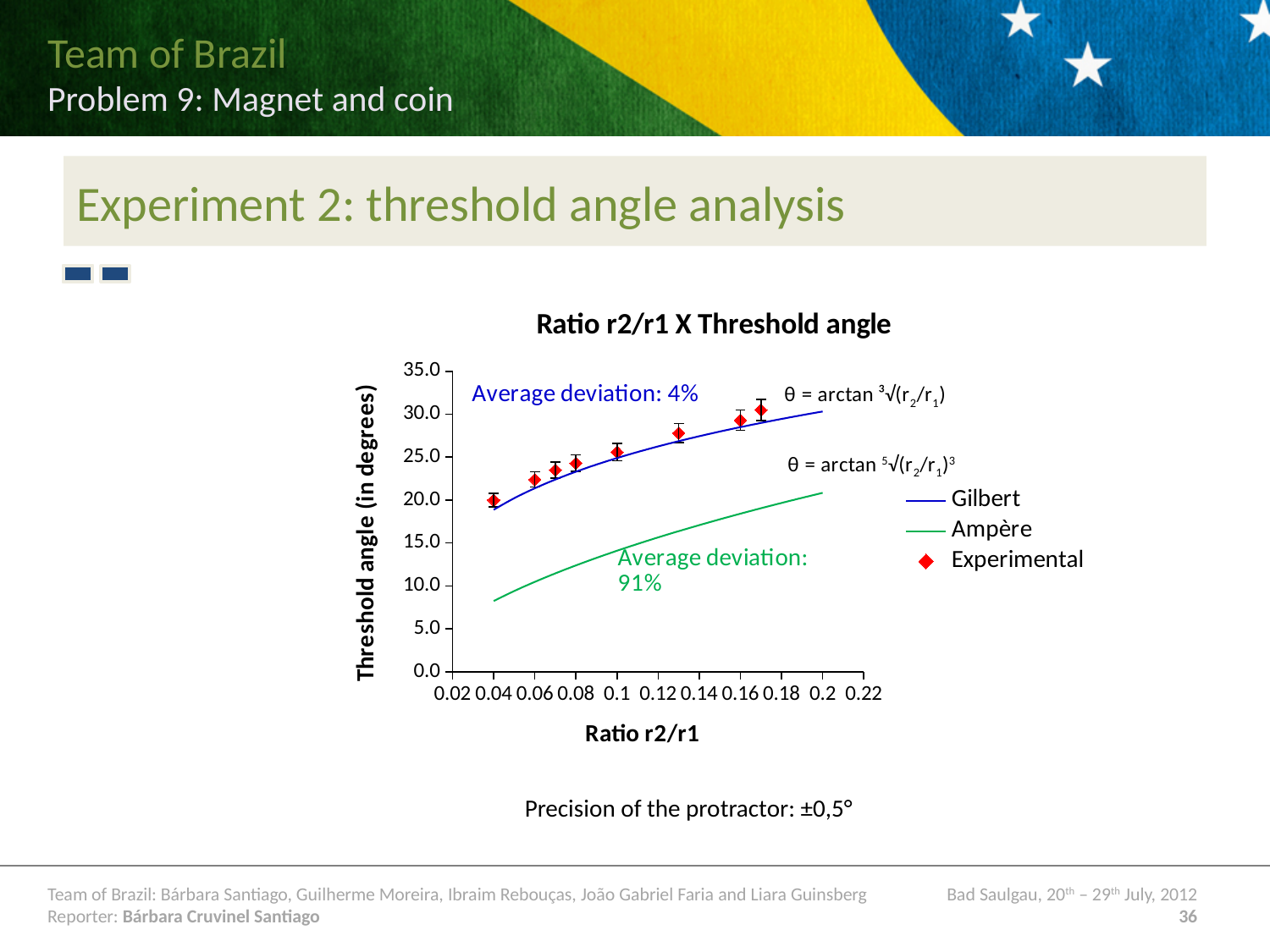
Is the experimental threshold angle at ratio 0.04 greater or less than 15.0 degrees? greater Does the Ampère curve rise or fall as the ratio r2/r1 increases? rise What are the three series named in the legend? Gilbert, Ampère, Experimental What average deviation is stated for the Ampère model? 91% Is the Gilbert curve value at ratio 0.2 greater or less than 25.0 degrees? greater How many series does the chart legend list? 3 Which curve lies higher on the chart, Gilbert or Ampère? Gilbert What is the label of the y axis? Threshold angle (in degrees) Is the Ampère curve value at ratio 0.04 greater or less than 10.0 degrees? less Do the experimental threshold angle values rise or fall as the ratio r2/r1 increases? rise What is the title of the chart? Ratio r2/r1 X Threshold angle What average deviation is stated for the Gilbert model? 4%